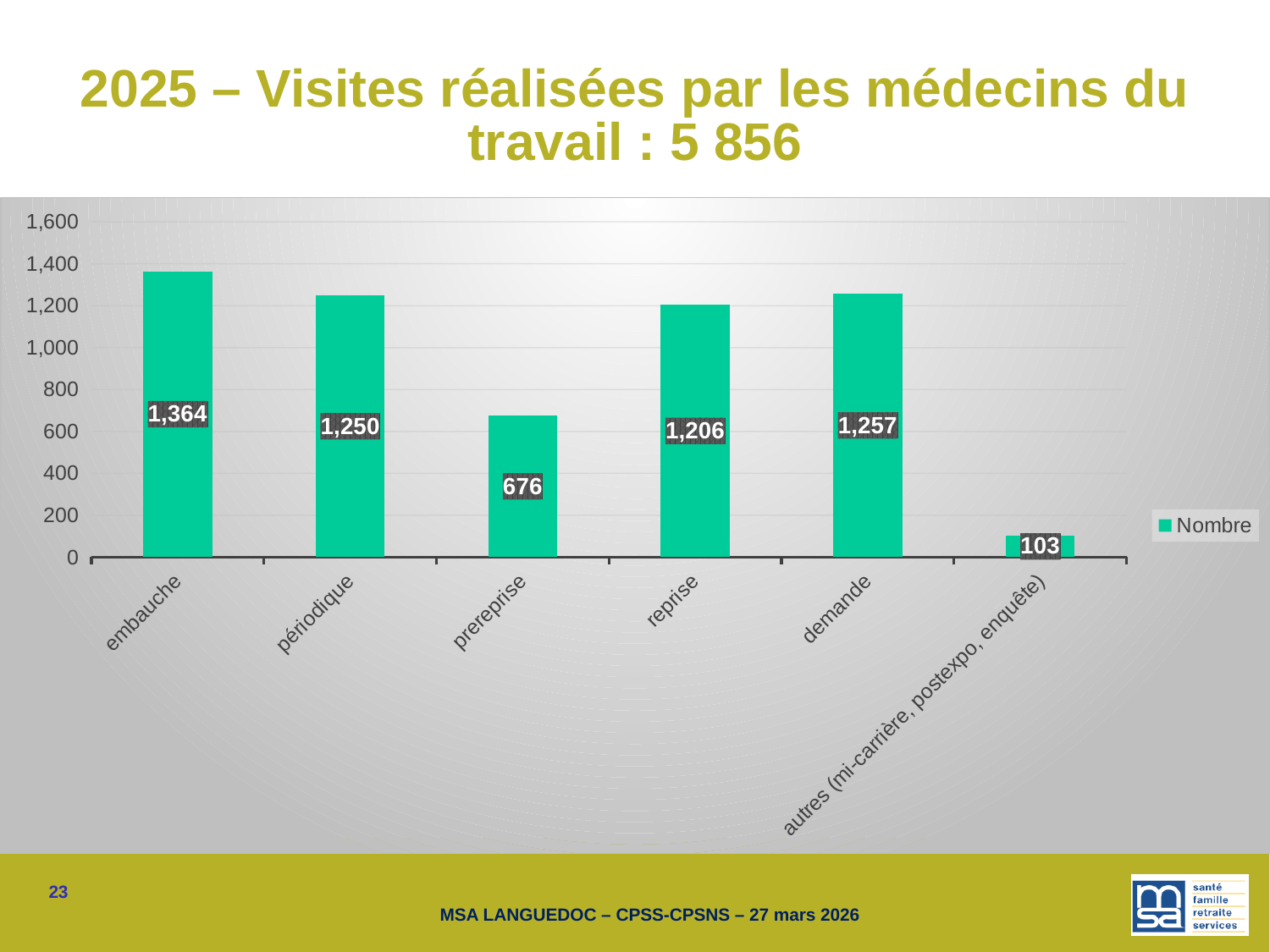
How many categories are shown on the x axis? 6 Which category has the highest value? embauche What is the difference between the values for embauche and périodique? 114 What kind of chart is shown on the slide? bar chart What is the value for prereprise? 676 Which is larger, the value for périodique or the value for reprise? périodique How many series does the legend list? 1 What is the value for embauche? 1,364 What is the value for autres (mi-carrière, postexpo, enquête)? 103 Is the value for prereprise greater or less than 800? less Which category has the lowest value? autres (mi-carrière, postexpo, enquête) What is the difference between the values for demande and reprise? 51